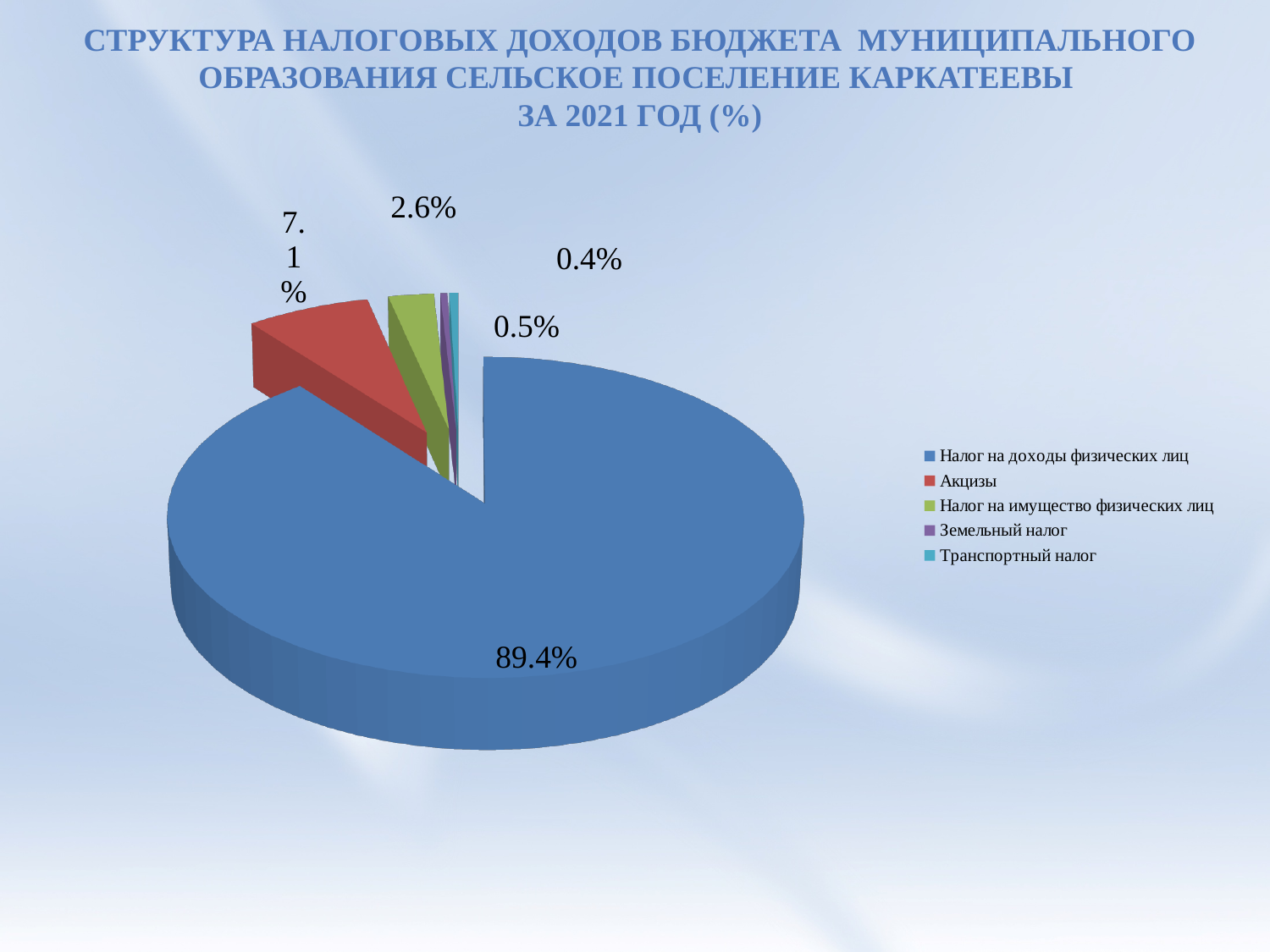
What kind of chart is shown on the slide? pie chart What share of tax revenues does Налог на доходы физических лиц account for? 89.4% How many categories does the legend list? 5 Which category has the largest share of the pie? Налог на доходы физических лиц What share of tax revenues does Акцизы account for? 7.1% What is the difference between the shares of Налог на доходы физических лиц and Акцизы? 82.3% What share of tax revenues does Налог на имущество физических лиц account for? 2.6% Which year does the chart title refer to? 2021 What is the difference between the shares of Акцизы and Налог на имущество физических лиц? 4.5% What colour represents Акцизы in the chart? red What is the smallest percentage value shown on the chart? 0.4% Which is larger, the share of Акцизы or the share of Налог на имущество физических лиц? Акцизы